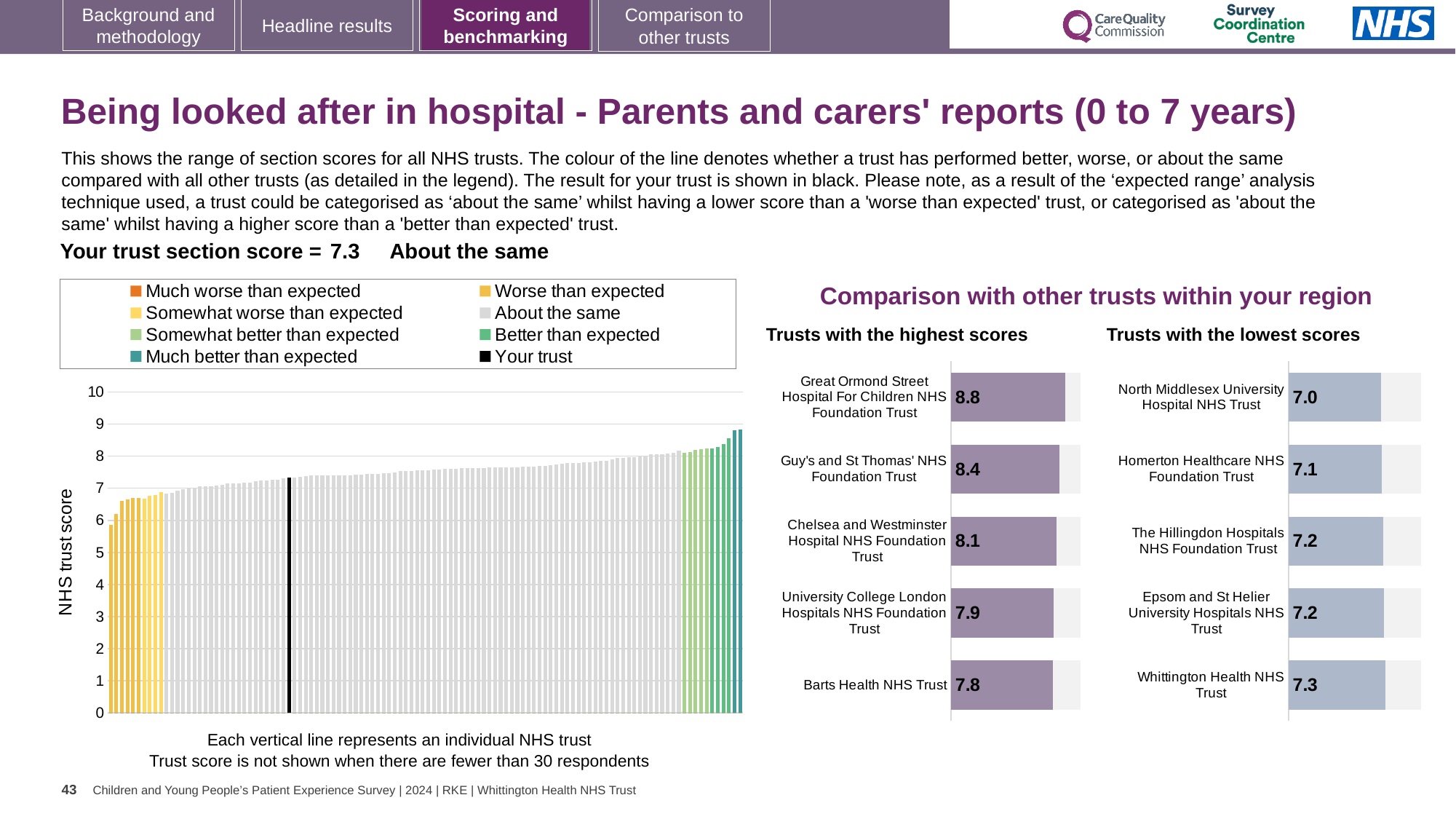
In the 'Trusts with the highest scores' chart, which trust has the highest score? Great Ormond Street Hospital For Children NHS Foundation Trust In the 'Trusts with the highest scores' chart, which has the higher score: Chelsea and Westminster Hospital NHS Foundation Trust or University College London Hospitals NHS Foundation Trust? Chelsea and Westminster Hospital NHS Foundation Trust In the 'Trusts with the lowest scores' chart, what is the score for Homerton Healthcare NHS Foundation Trust? 7.1 In the 'Trusts with the highest scores' chart, what is the difference between the scores of Great Ormond Street Hospital For Children NHS Foundation Trust and Barts Health NHS Trust? 1.0 What is the label on the vertical axis of the large chart on the left? NHS trust score In the 'Trusts with the highest scores' chart, what is the score for Great Ormond Street Hospital For Children NHS Foundation Trust? 8.8 In the 'Trusts with the lowest scores' chart, what is the difference between the scores of Whittington Health NHS Trust and North Middlesex University Hospital NHS Trust? 0.3 How many entries does the legend of the large chart on the left list? 8 How many trusts are shown in the 'Trusts with the lowest scores' chart? 5 In the 'Trusts with the lowest scores' chart, which trust has the lowest score? North Middlesex University Hospital NHS Trust In the large chart on the left, do the trust scores rise or fall from left to right? Rise What kind of chart is the large chart on the left showing NHS trust scores? Bar chart